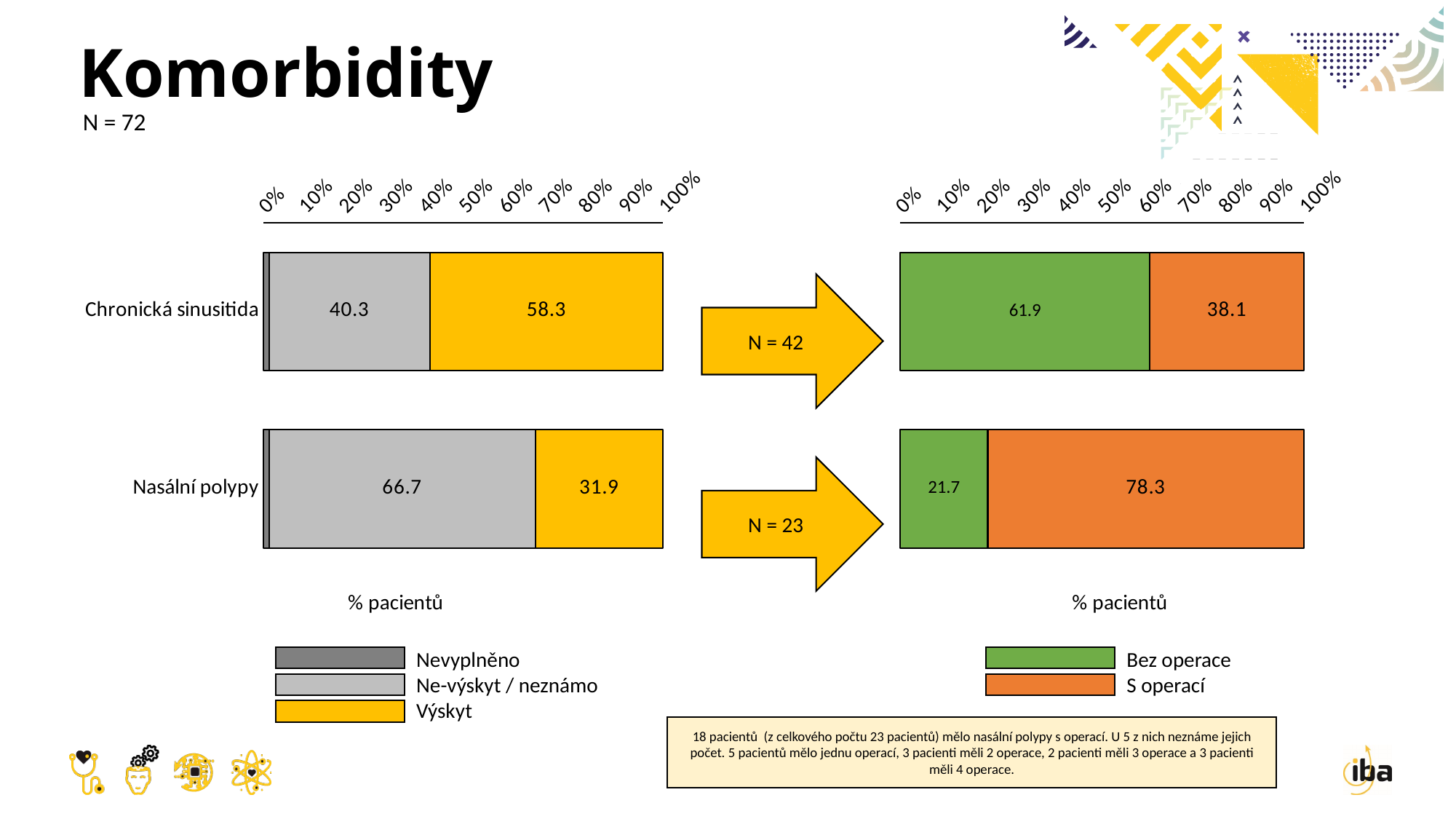
In the right chart, is the S operací value for Chronická sinusitida larger or smaller than the Bez operace value? smaller In the right chart, what is the difference between the S operací values for Nasální polypy and Chronická sinusitida? 40.2 In the left chart, what is the difference between the Výskyt values for Chronická sinusitida and Nasální polypy? 26.4 In the right chart, what is the S operací value for Nasální polypy? 78.3 In the right chart, what is the Bez operace value for Chronická sinusitida? 61.9 In the left chart, which category has the higher Výskyt value? Chronická sinusitida How many categories are shown in the right chart? 2 In the left chart, what is the Výskyt value for Chronická sinusitida? 58.3 How many series does the legend of the left chart list? 3 In the right chart, which category has the lower Bez operace value? Nasální polypy In the left chart, what is the Ne-výskyt / neznámo value for Nasální polypy? 66.7 What kind of chart is the left chart? stacked bar chart